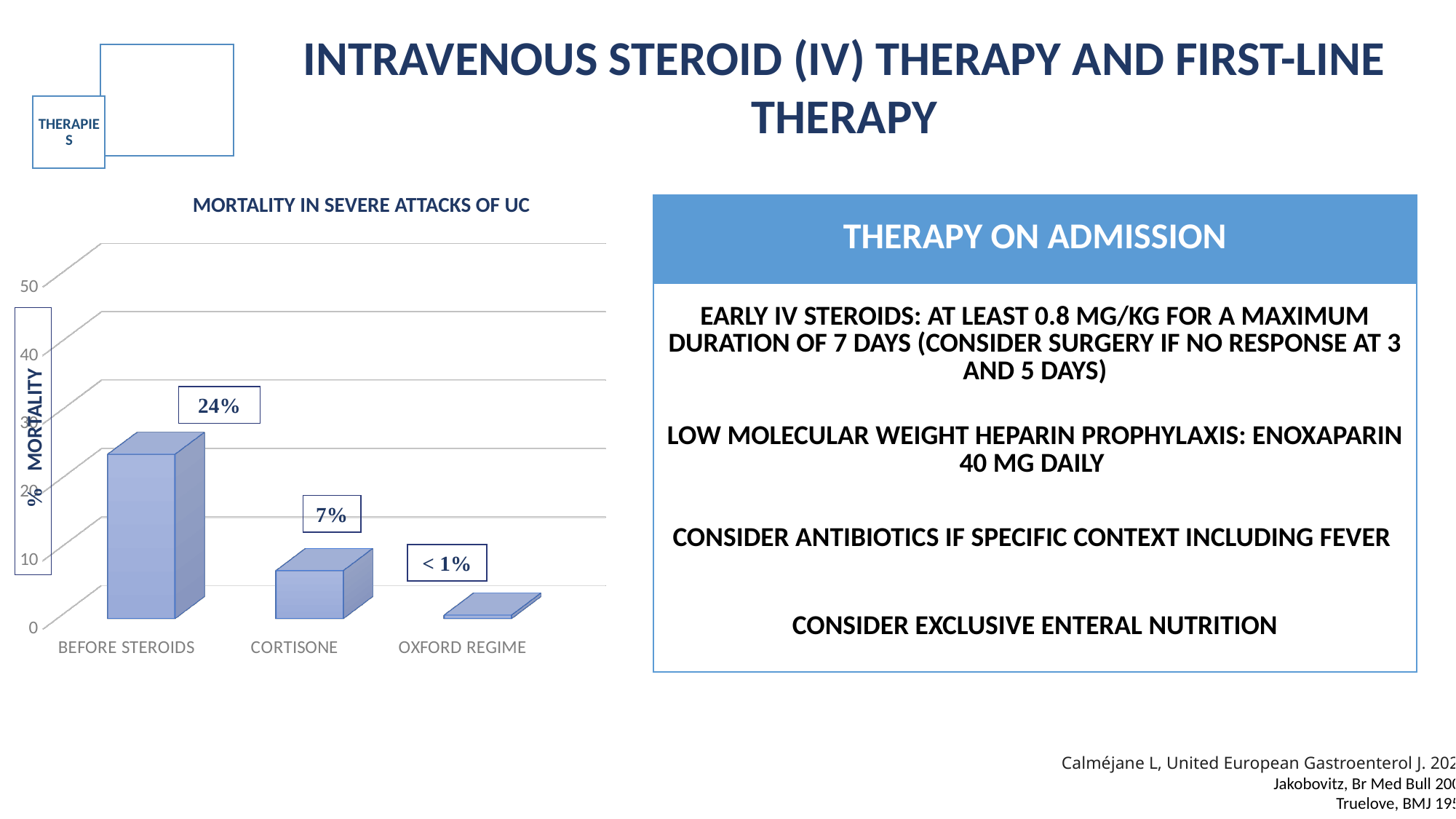
How many categories are shown on the x axis of the chart? 3 Is the mortality for CORTISONE greater or less than 10? less Which category has the lowest mortality? OXFORD REGIME What is the mortality value shown for OXFORD REGIME? < 1% What kind of chart is used to show mortality in severe attacks of UC? Bar chart What is the mortality value shown for BEFORE STEROIDS? 24% Which has a higher mortality, CORTISONE or OXFORD REGIME? CORTISONE What is the difference in mortality between BEFORE STEROIDS and CORTISONE? 17% Is the mortality for BEFORE STEROIDS greater or less than 20? greater What is the mortality value shown for CORTISONE? 7% What is the title of the chart? MORTALITY IN SEVERE ATTACKS OF UC Which category has the highest mortality? BEFORE STEROIDS